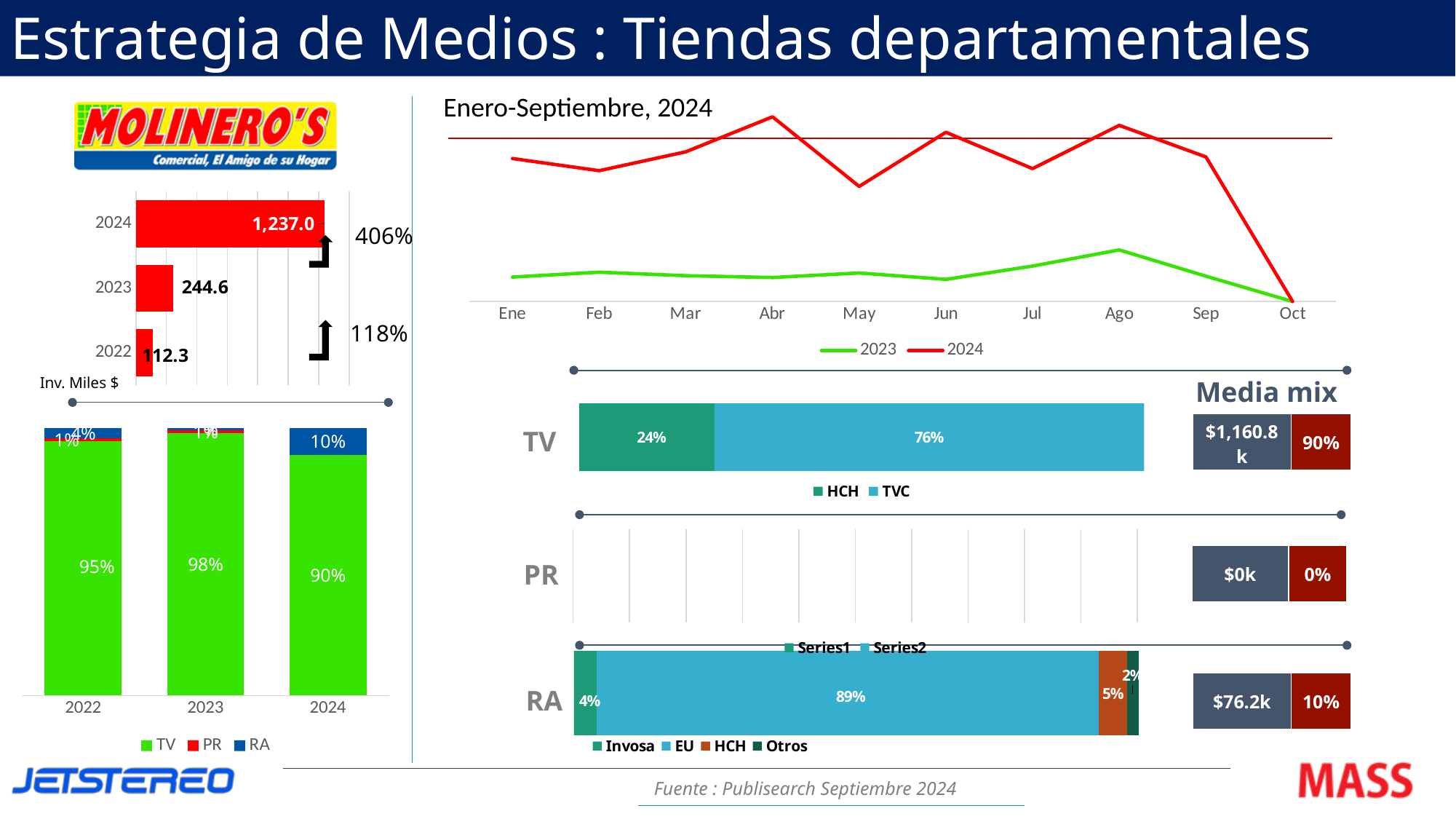
In the line chart at the top right, which series is drawn in red? 2024 In the top-left bar chart (Inv. Miles $), what percentage growth is shown between 2023 and 2024? 406% In the top-left bar chart (Inv. Miles $), what is the value for 2024? 1,237.0 In the bottom-left stacked bar chart, what is the RA share for 2024? 10% In the top-left bar chart (Inv. Miles $), what is the value for 2022? 112.3 In the RA stacked bar on the right, what share does EU have? 89% In the top-left bar chart (Inv. Miles $), which year has the lowest value? 2022 In the top-left bar chart (Inv. Miles $), what is the difference between the 2023 and 2022 values? 132.3 In the bottom-left stacked bar chart, what is the TV share for 2023? 98% In the TV stacked bar on the right, what share does TVC have? 76% In the line chart at the top right, how many months are shown on the x axis? 10 How many series does the legend of the bottom-left stacked bar chart list? 3